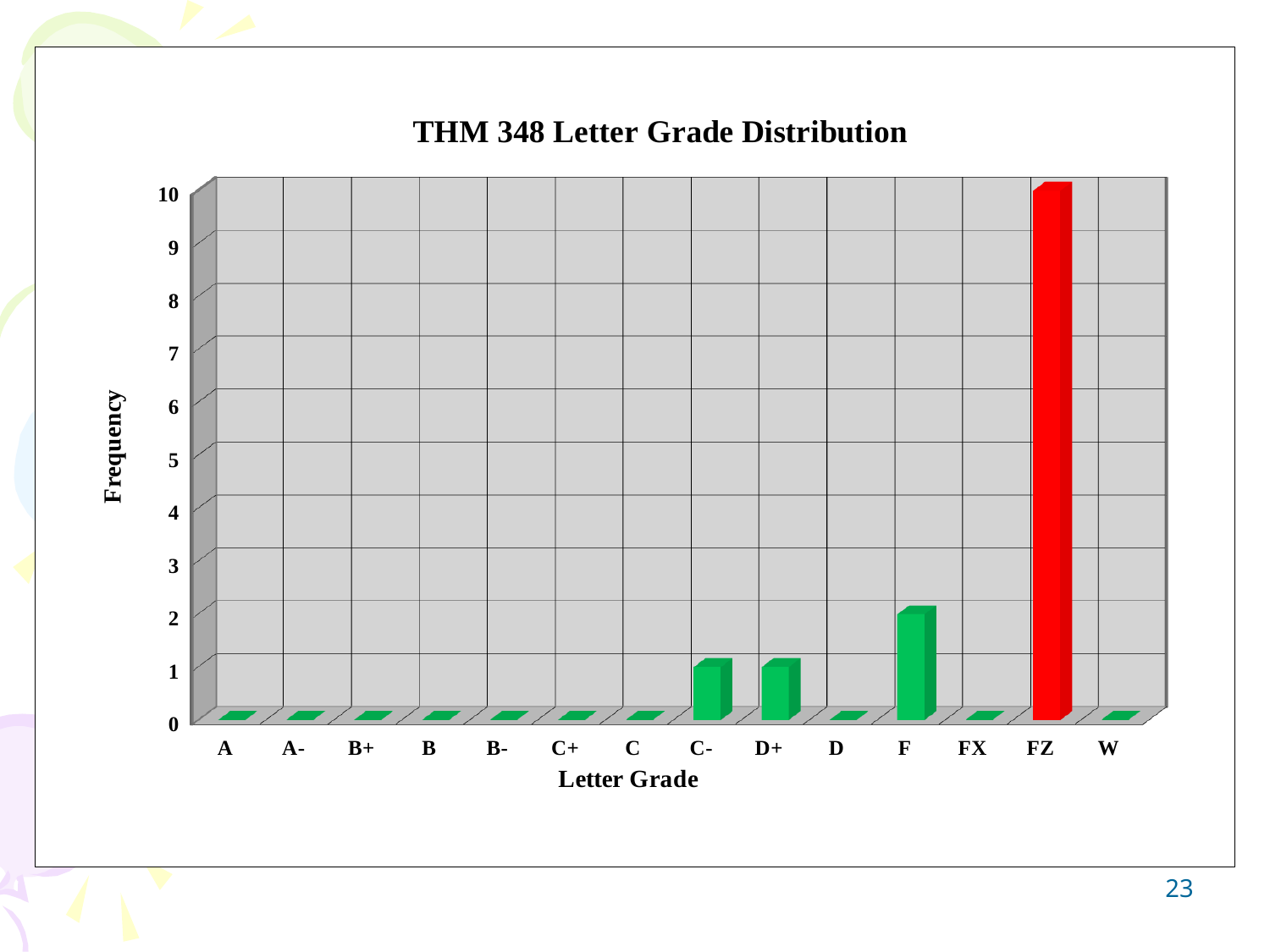
What kind of chart is shown on the slide? bar chart What is the frequency for the F grade? 2 What is the title of the chart? THM 348 Letter Grade Distribution How many letter grade categories are shown on the x axis? 14 What colour is the bar for the FZ grade? red Which letter grade has the highest frequency? FZ What is the difference in frequency between FZ and F? 8 What is the frequency for the D+ grade? 1 Is the frequency for FZ greater or less than 5? greater What is the frequency for the FZ grade? 10 What is the frequency for the C- grade? 1 Which has a higher frequency, F or C-? F